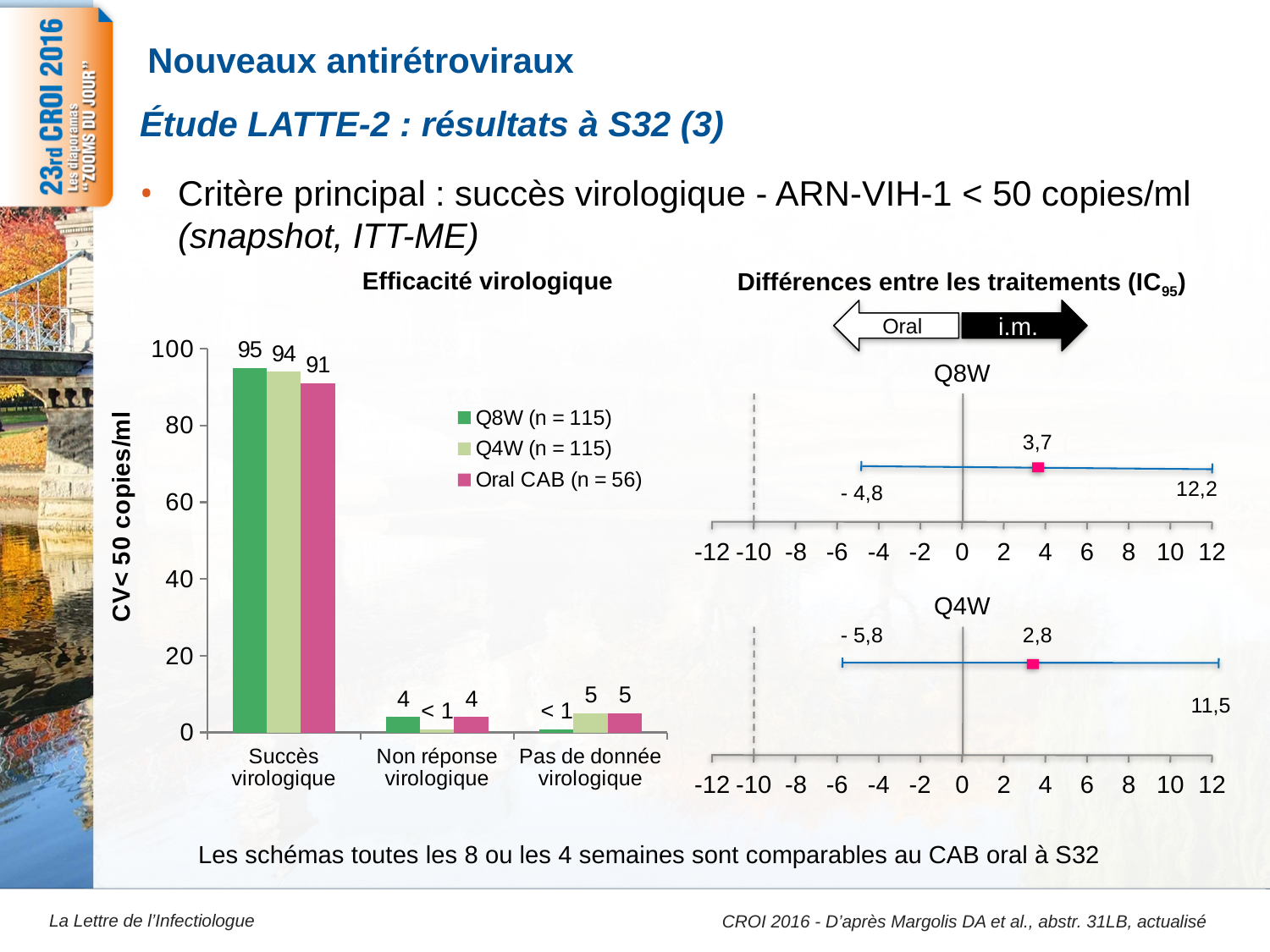
In the 'Efficacité virologique' bar chart, what is the value for Q8W (n = 115) in the 'Succès virologique' category? 95 In the 'Efficacité virologique' bar chart, what is the difference between the Q8W and Oral CAB values in the 'Succès virologique' category? 4 In the 'Différences entre les traitements (IC95)' chart, what is the point estimate of the difference for Q8W? 3,7 In the 'Efficacité virologique' bar chart, how many series does the legend list? 3 In the 'Différences entre les traitements (IC95)' chart, which treatment has the larger point estimate, Q8W or Q4W? Q8W In the 'Différences entre les traitements (IC95)' chart, what are the lower and upper confidence limits for Q4W? - 5,8 and 11,5 In the 'Efficacité virologique' bar chart, what is the value for Q4W (n = 115) in the 'Pas de donnée virologique' category? 5 In the 'Efficacité virologique' bar chart, is the Q4W value in the 'Succès virologique' category greater or less than 80? greater In the 'Efficacité virologique' bar chart, how many categories are shown on the x axis? 3 What kind of chart is 'Efficacité virologique'? Bar chart In the 'Efficacité virologique' bar chart, which series has the highest value in the 'Succès virologique' category? Q8W (n = 115) In the 'Efficacité virologique' bar chart, what is the value for Oral CAB (n = 56) in the 'Succès virologique' category? 91